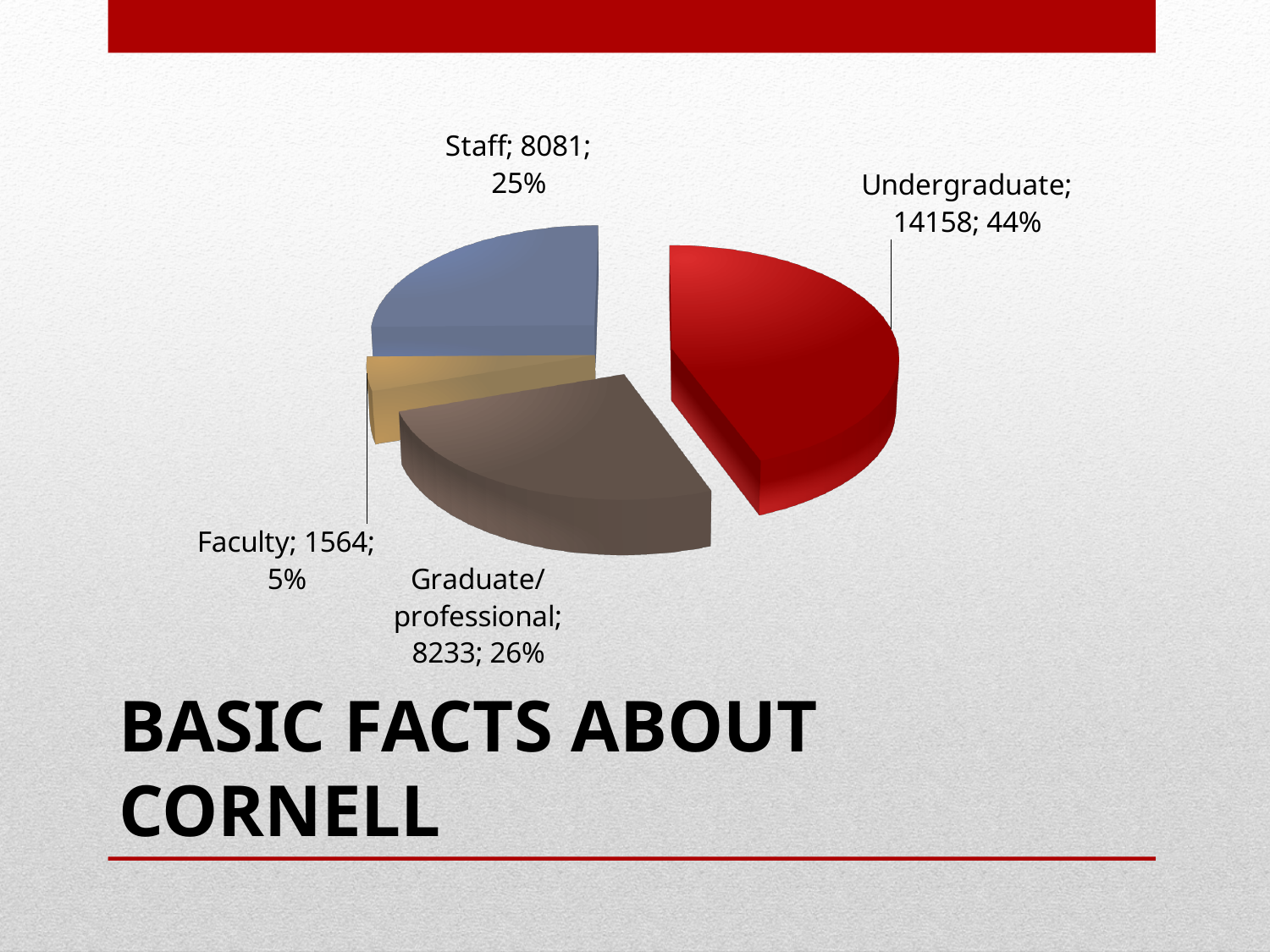
What percentage share of the pie does Graduate/professional have? 26% Which is larger, the value for Graduate/professional or the value for Staff? Graduate/professional What value is shown for Undergraduate? 14158 How many slices does the pie chart have? 4 What value is shown for Faculty? 1564 What value is shown for Staff? 8081 What is the difference between the Undergraduate value and the Faculty value? 12594 What kind of chart is shown on the slide? Pie chart Which category has the smallest slice of the pie? Faculty Which category has the largest slice of the pie? Undergraduate What percentage share of the pie does Staff have? 25% What value is shown for Graduate/professional? 8233